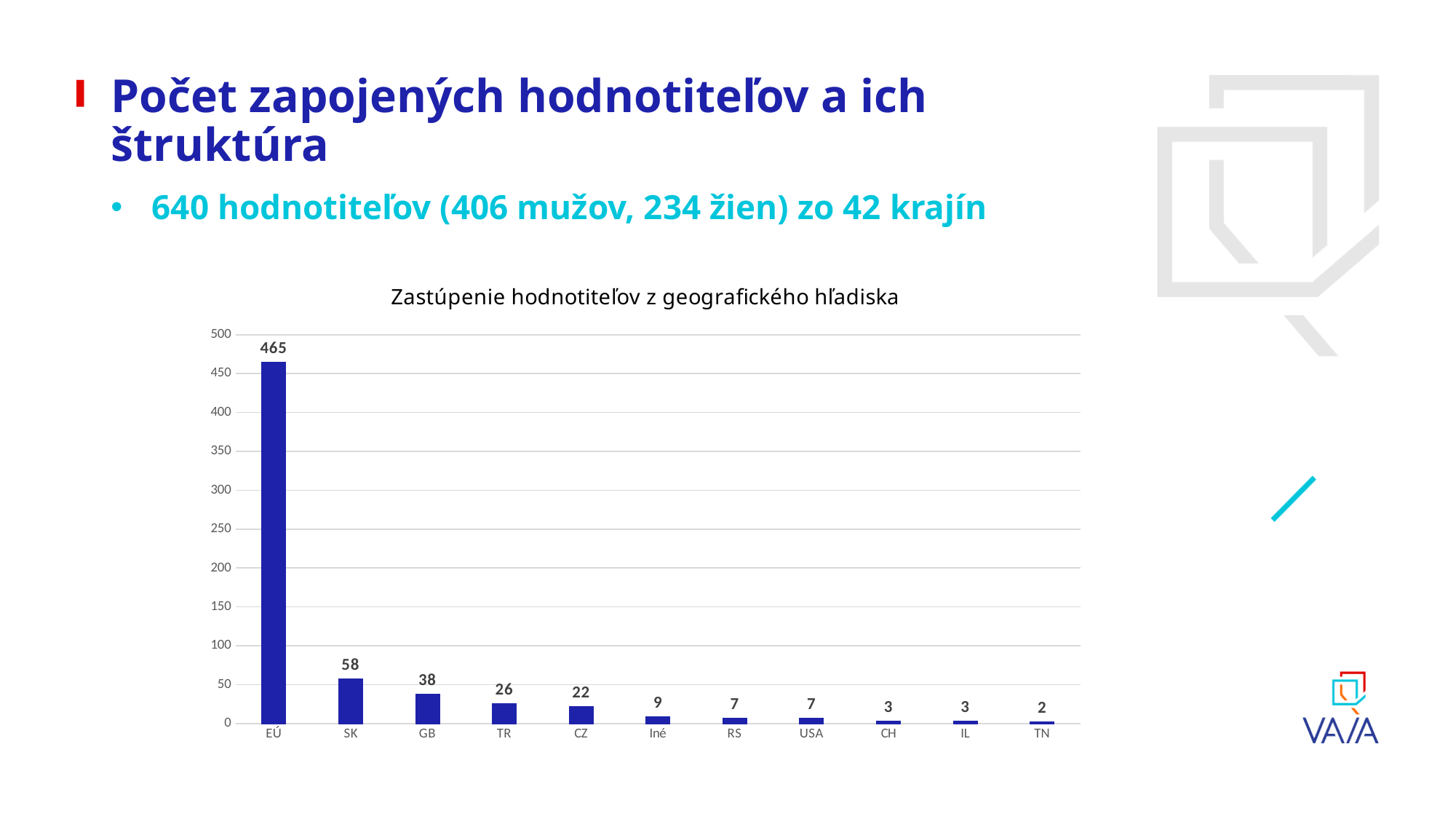
What is the value for GB? 38 Is the value for EÚ greater or less than 400? greater What is the title of the chart? Zastúpenie hodnotiteľov z geografického hľadiska What is the difference between the values for SK and GB? 20 What kind of chart is shown? bar chart Which is larger, the value for CZ or the value for TR? TR Which category has the lowest value? TN How many categories are shown on the x axis? 11 Which category has the highest value? EÚ What is the value for EÚ? 465 What is the value for SK? 58 What is the value for TR? 26